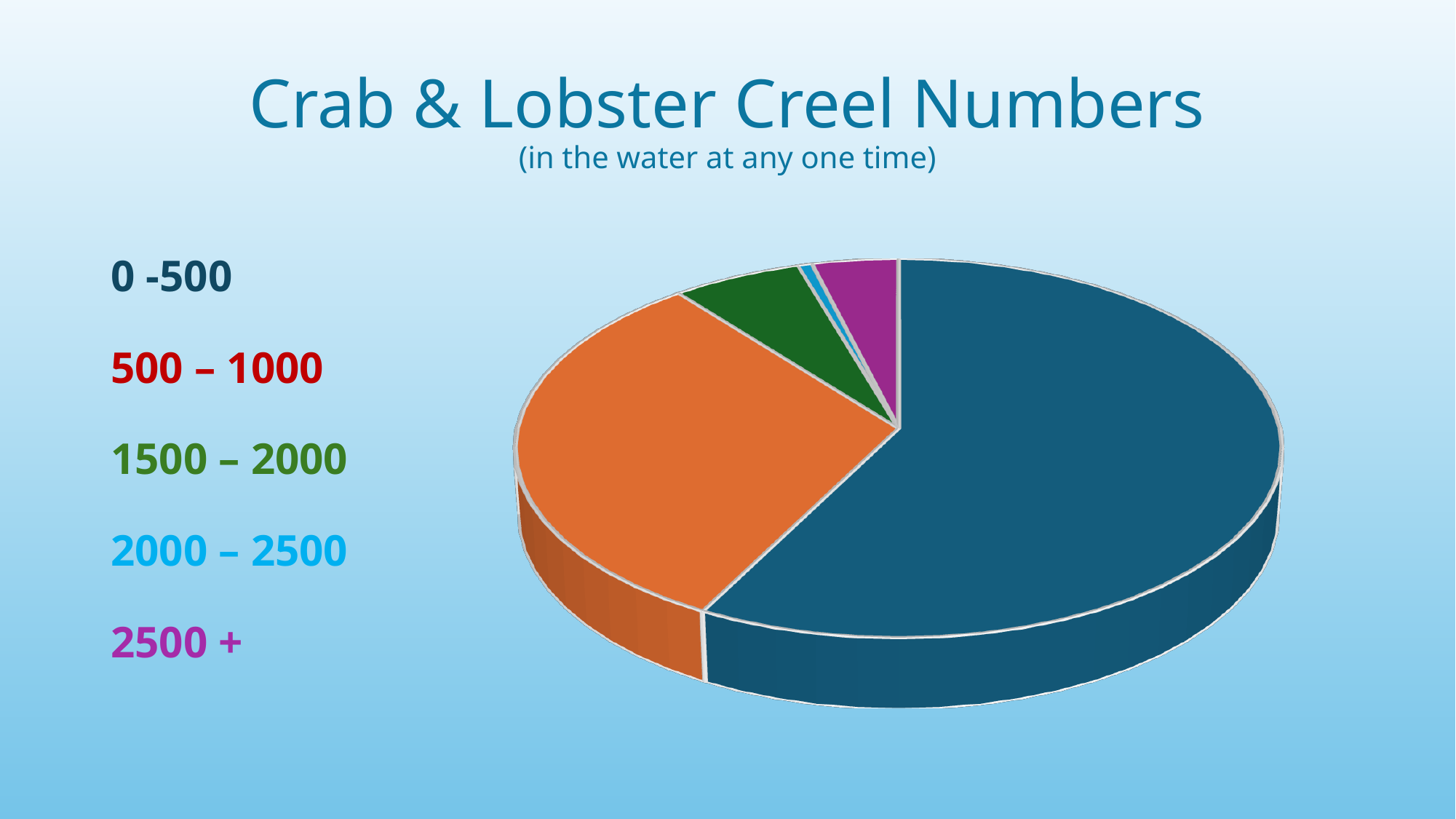
What is the title of the chart on the slide? Crab & Lobster Creel Numbers What kind of chart is shown on the slide? pie chart Does the 0 -500 slice take up more or less than half of the pie? more Which category has the largest slice of the pie chart? 0 -500 Which category is the second-largest slice of the pie chart? 500 – 1000 How many categories (slices) does the pie chart have? 5 Which category has the smallest slice of the pie chart? 2000 – 2500 Which slice is larger: 0 -500 or 500 – 1000? 0 -500 What is the subtitle shown under the chart title? (in the water at any one time) Which slice is larger: 2500 + or 2000 – 2500? 2500 +